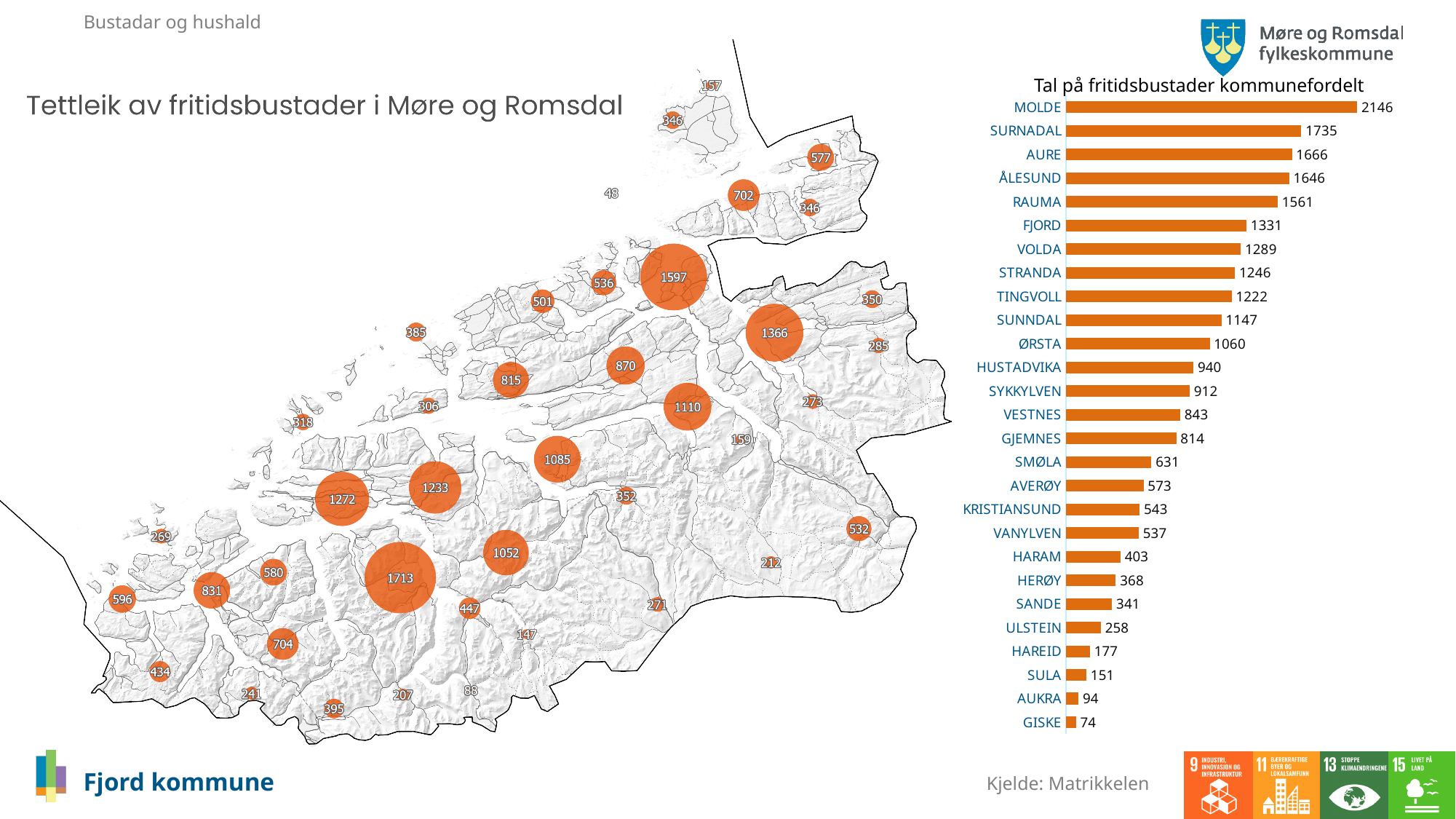
In the bar chart 'Tal på fritidsbustader kommunefordelt', what is the value for KRISTIANSUND? 543 In the bar chart 'Tal på fritidsbustader kommunefordelt', which has a larger value, HERØY or SANDE? HERØY What kind of chart is 'Tal på fritidsbustader kommunefordelt'? Bar chart How many municipalities are shown in the bar chart 'Tal på fritidsbustader kommunefordelt'? 27 In the bar chart 'Tal på fritidsbustader kommunefordelt', what is the value for MOLDE? 2146 In the bar chart 'Tal på fritidsbustader kommunefordelt', what is the difference between the values for MOLDE and GISKE? 2072 In the bar chart 'Tal på fritidsbustader kommunefordelt', what is the value for FJORD? 1331 What is the title of the bar chart on the right side of the slide? Tal på fritidsbustader kommunefordelt In the bar chart 'Tal på fritidsbustader kommunefordelt', which municipality has the highest value? MOLDE In the bar chart 'Tal på fritidsbustader kommunefordelt', what is the difference between the values for SURNADAL and AURE? 69 In the bar chart 'Tal på fritidsbustader kommunefordelt', which municipality has the lowest value? GISKE In the bar chart 'Tal på fritidsbustader kommunefordelt', which has a larger value, VOLDA or STRANDA? VOLDA